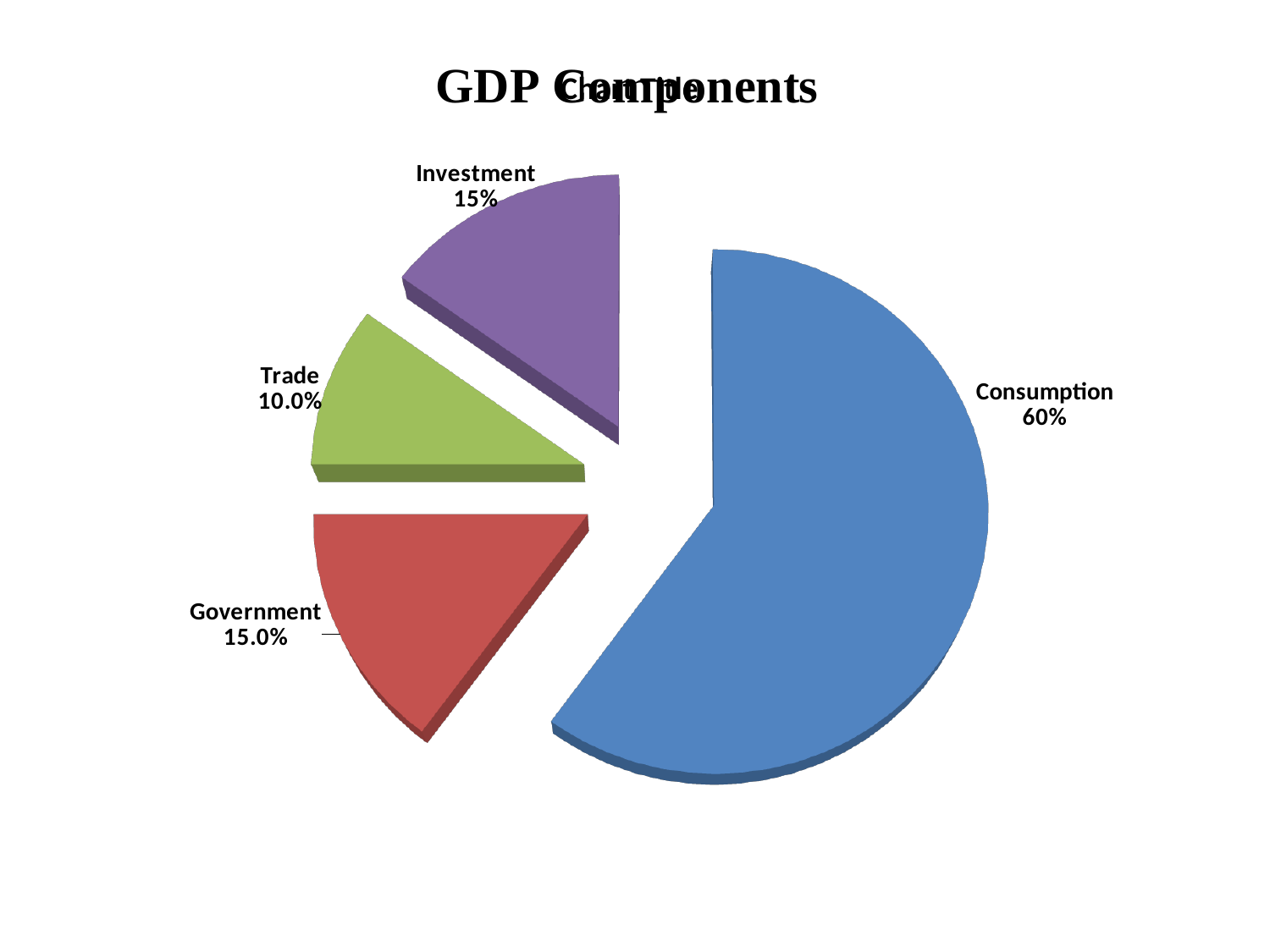
Which GDP component has the largest slice of the pie? Consumption What percentage does the Consumption slice show? 60% What kind of chart is shown on the slide? Pie chart What percentage does the Trade slice show? 10.0% Which GDP component has the smallest slice of the pie? Trade What is the difference in percentage points between the Consumption slice and the Trade slice? 50 What percentage does the Investment slice show? 15% What percentage does the Government slice show? 15.0% Which is larger, the Consumption slice or the Trade slice? Consumption How many slices does the pie chart have? 4 What share of the pie does Government account for? 15.0% What colour is the Consumption slice? Blue